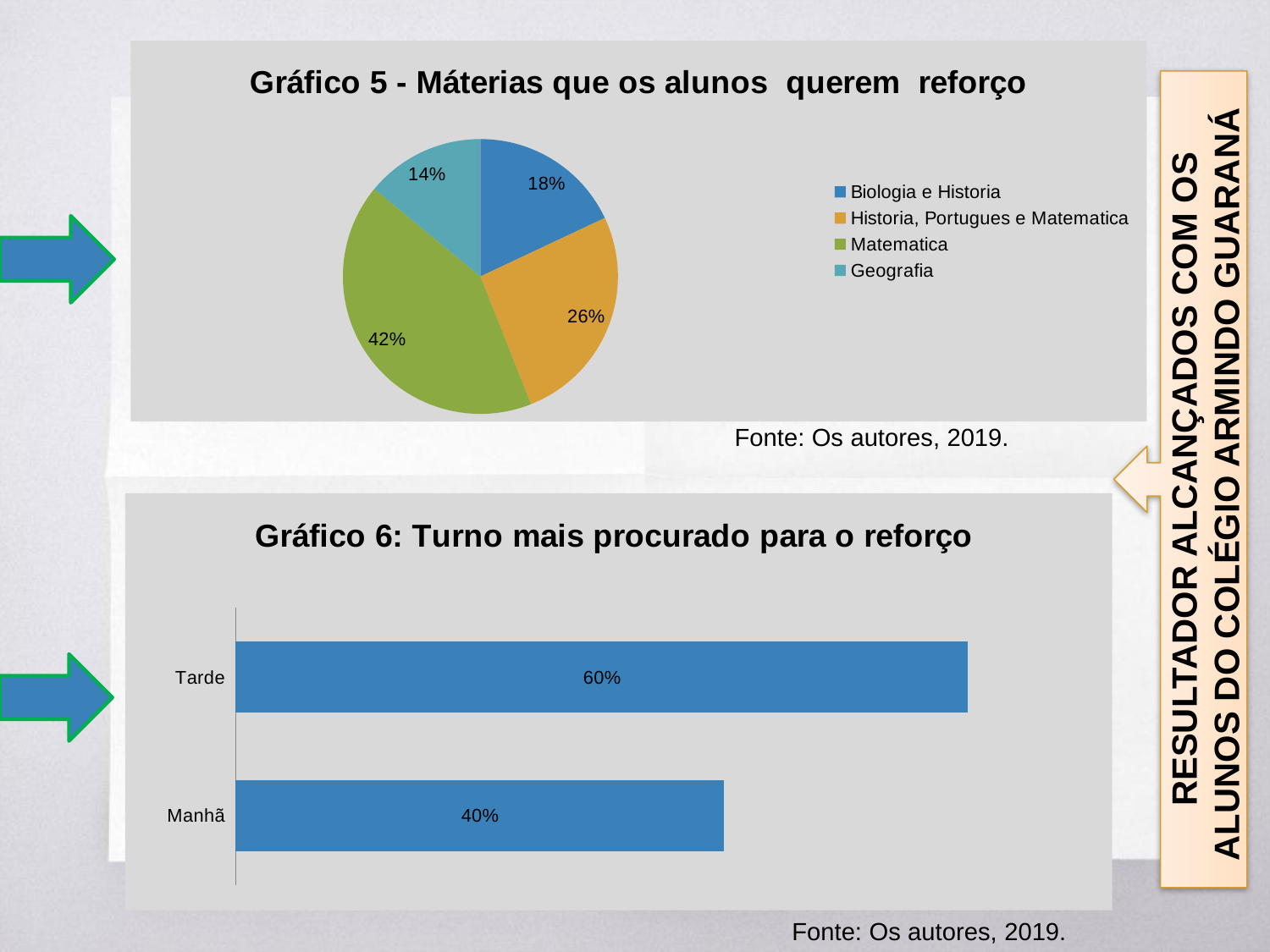
In Gráfico 5, what percentage is shown for Geografia? 14% In Gráfico 6, what is the value for Tarde? 60% What kind of chart is Gráfico 5? Pie chart In Gráfico 5, what percentage is shown for Biologia e Historia? 18% What kind of chart is Gráfico 6? Bar chart In Gráfico 6, what is the difference between Tarde and Manhã? 20% In Gráfico 5, which subject has the smallest slice? Geografia In Gráfico 5, what is the difference between the Matematica slice and the Historia, Portugues e Matematica slice? 16% In Gráfico 5, how many entries does the legend list? 4 In Gráfico 5, what share of the pie is Matematica? 42% In Gráfico 5, which subject has the largest slice? Matematica In Gráfico 6, which shift has the lower value? Manhã